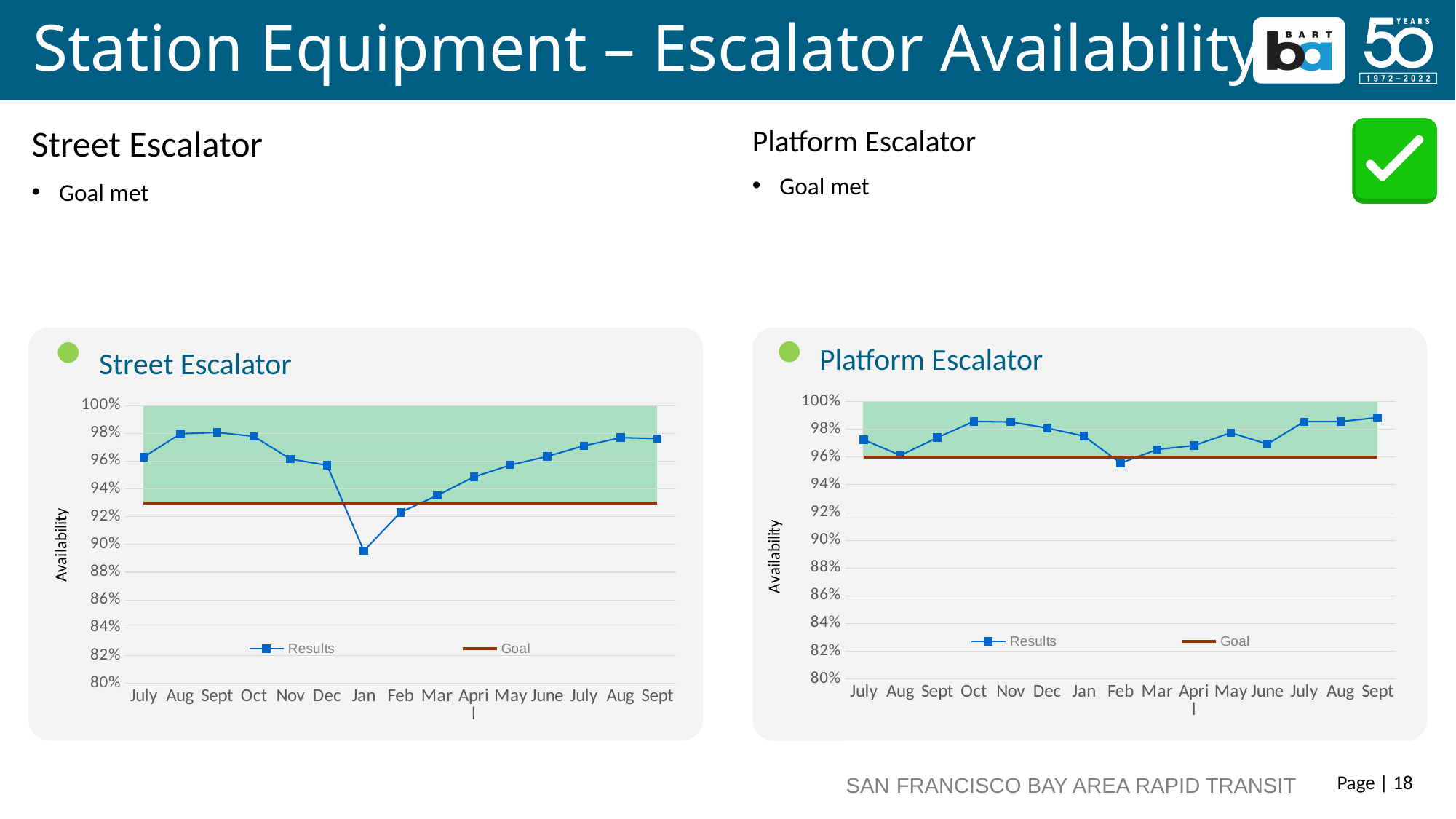
In the Street Escalator chart, is the Results value for Jan greater or less than 92%? less In the Street Escalator chart, is the Results value for Mar greater or less than 92%? greater How many series does the legend of the Platform Escalator chart list? 2 In the Street Escalator chart, which is larger: the Results value for the first Sept or for Jan? Sept How many months are plotted along the x axis of the Street Escalator chart? 15 In the Street Escalator chart, do the Results values rise or fall from Jan to the final Sept? rise What are the two legend entries in the Platform Escalator chart? Results and Goal What is the y-axis label of the Street Escalator chart? Availability In the Platform Escalator chart, which month has the lowest Results value? Feb In the Platform Escalator chart, is the Results value for Feb greater or less than 96%? less In the Street Escalator chart, which month has the lowest Results value? Jan What kind of chart is the Street Escalator chart? line chart